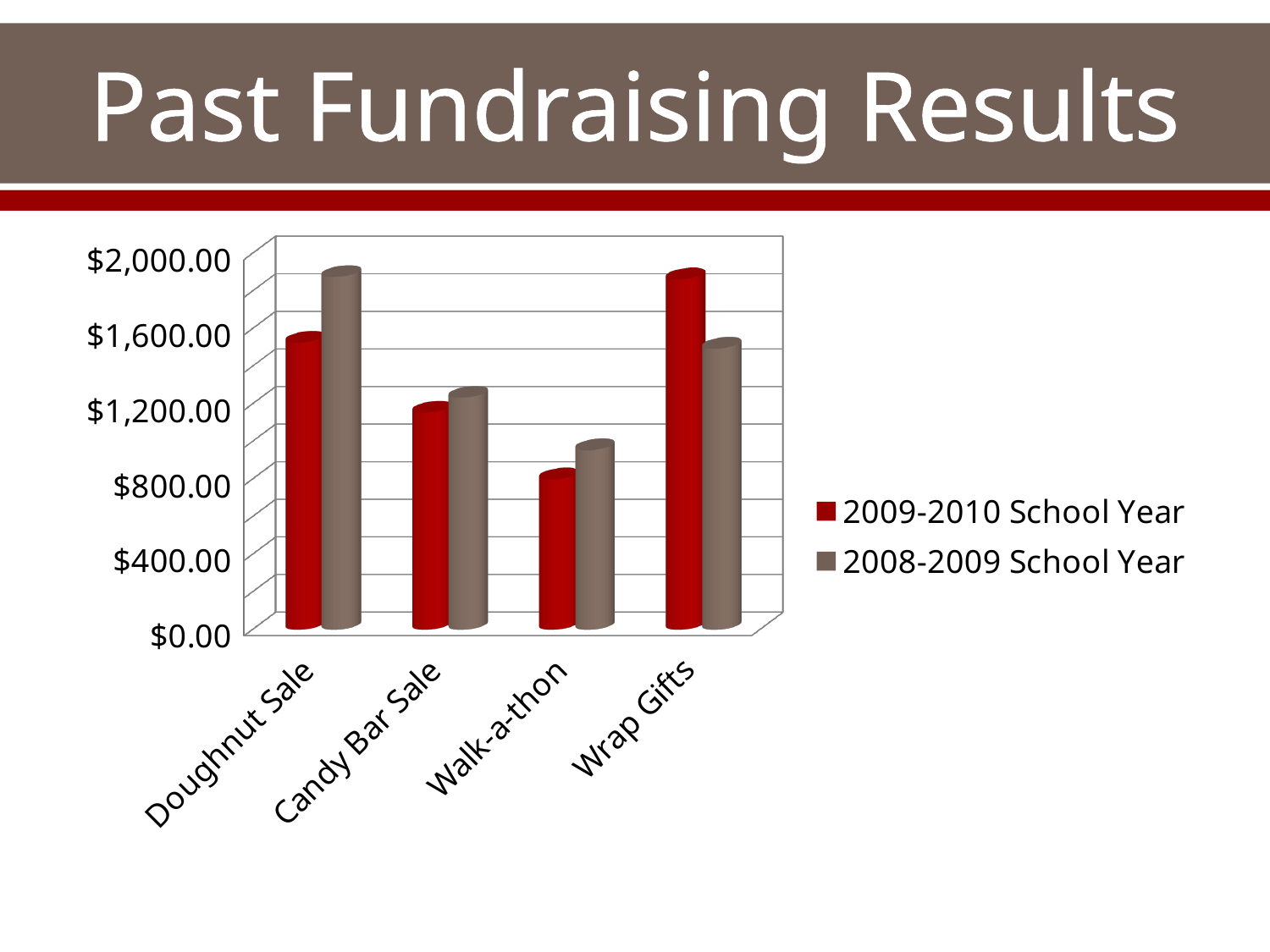
Is the value for the Walk-a-thon in the 2009-2010 School Year greater or less than $1,200.00? less How many series does the legend list? 2 Which fundraiser had the lowest value in the 2009-2010 School Year? Walk-a-thon Is the value for the Doughnut Sale in the 2008-2009 School Year greater or less than $1,600.00? greater How many fundraising categories are shown on the x axis? 4 Which fundraiser had the highest value in the 2009-2010 School Year? Wrap Gifts What is the title of the chart? Past Fundraising Results What kind of chart is shown on the slide? bar chart Which colour represents the 2009-2010 School Year series? red Which fundraiser had the highest value in the 2008-2009 School Year? Doughnut Sale For the Doughnut Sale, which school year had the larger value? 2008-2009 School Year For Wrap Gifts, which school year had the larger value? 2009-2010 School Year